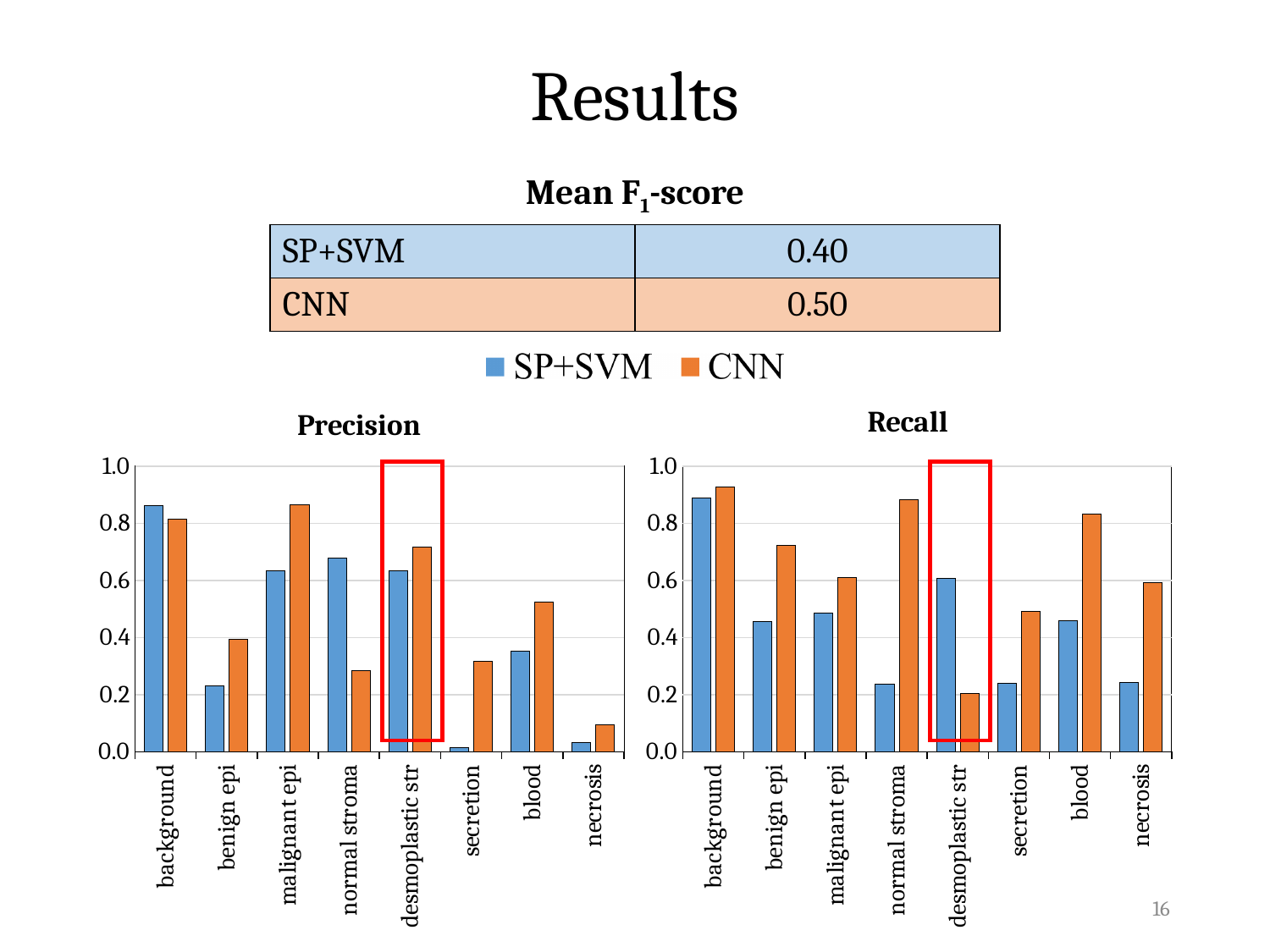
In the Recall chart, is the CNN value for normal stroma greater or less than 0.8? greater In the Recall chart, which category has the highest SP+SVM value? background In the Precision chart, which series has the larger value for normal stroma, SP+SVM or CNN? SP+SVM What kind of chart is the Precision chart? bar chart In the Precision chart, is the SP+SVM value for secretion greater or less than 0.2? less In the Precision chart, which category has the highest CNN value? malignant epi In the Precision chart, which category has the lowest CNN value? necrosis How many series does the legend list for the Precision and Recall charts? 2 Which category is highlighted with a red box in both the Precision and Recall charts? desmoplastic str How many categories are shown on the x axis of the Recall chart? 8 In the Recall chart, which series has the larger value for desmoplastic str, SP+SVM or CNN? SP+SVM In the Precision chart, is the CNN value for malignant epi greater or less than 0.8? greater